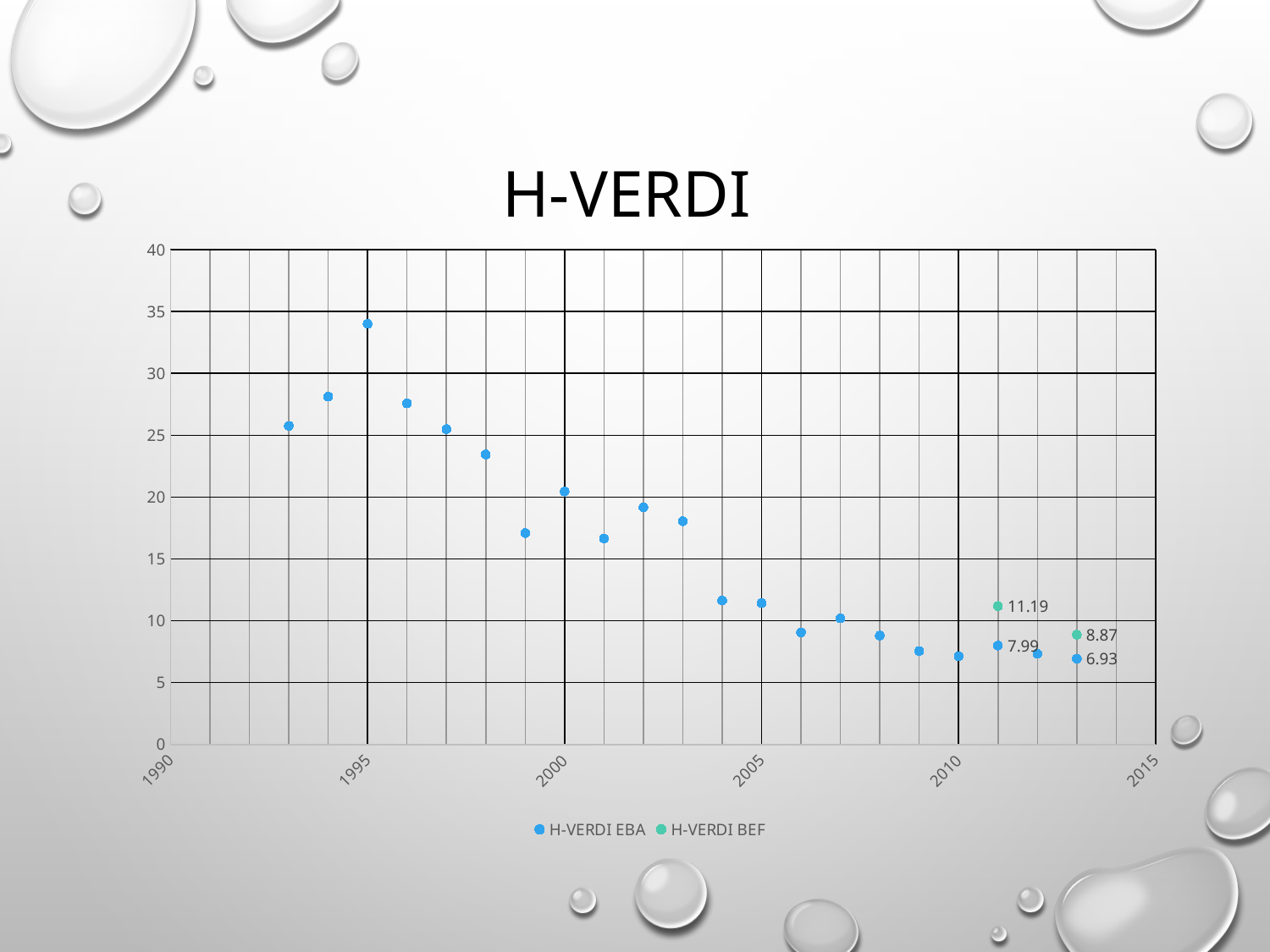
What is the title of the chart? H-VERDI What is the labelled value of H-VERDI BEF in 2011? 11.19 What is the difference between the H-VERDI BEF and H-VERDI EBA values in 2013? 1.94 What is the labelled value of H-VERDI BEF in 2013? 8.87 What is the labelled value of H-VERDI EBA in 2013? 6.93 What is the difference between the H-VERDI BEF and H-VERDI EBA values in 2011? 3.20 What kind of chart is shown on the slide? scatter chart How many series does the legend list? 2 Do the H-VERDI EBA values generally rise or fall from the early 1990s to 2013? fall Is the H-VERDI EBA value for 1995 greater or less than 30? greater In 2011, which series has the larger value, H-VERDI EBA or H-VERDI BEF? H-VERDI BEF What is the labelled value of H-VERDI EBA in 2011? 7.99